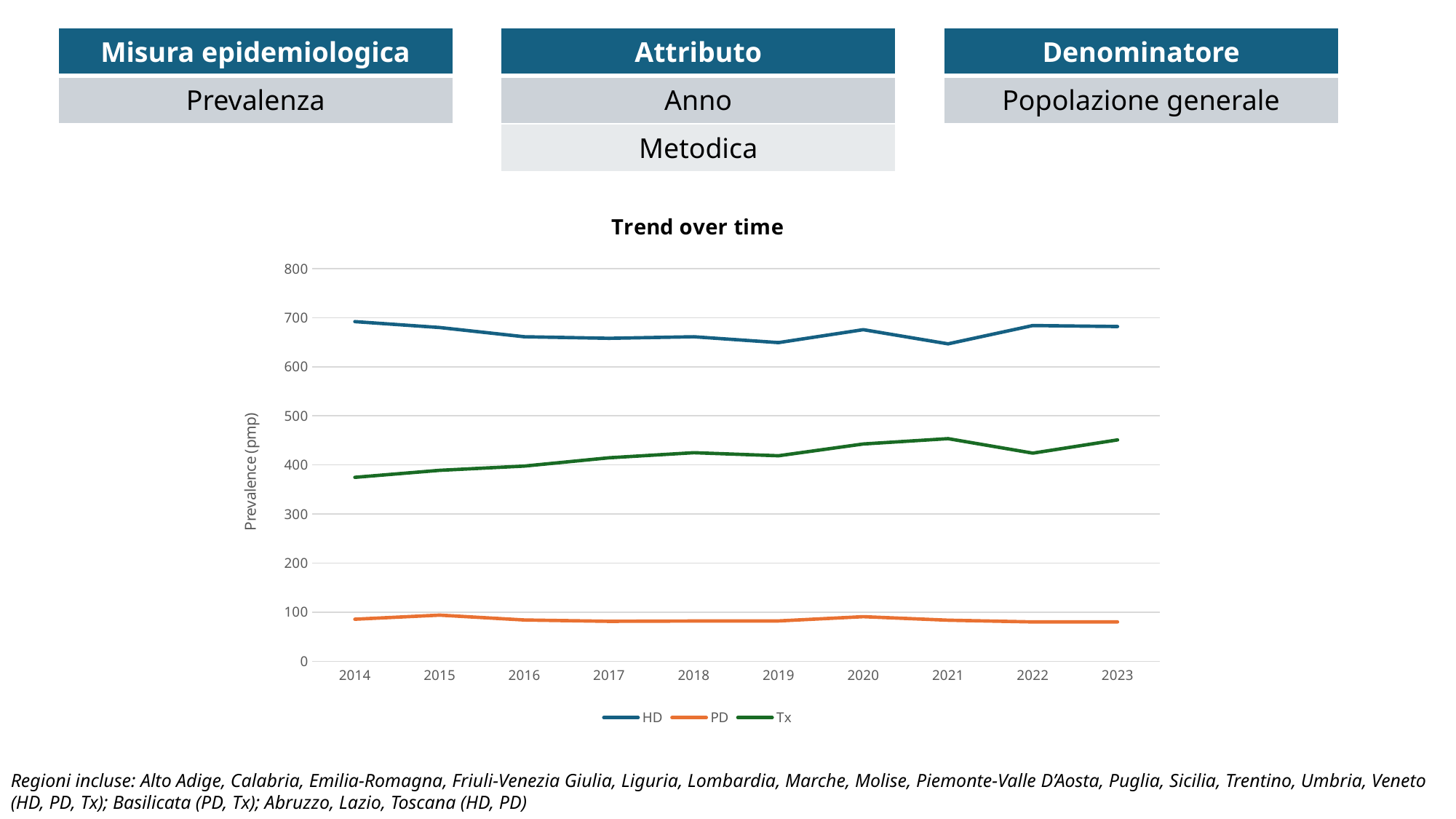
Is the value for HD in 2014 greater or less than 600? greater Does the Tx series rise or fall overall from 2014 to 2023? rise Is the value for Tx in 2021 greater or less than 400? greater How many series does the legend of the "Trend over time" chart list? 3 Which series has the lowest values across all years shown? PD Is the value for PD in 2023 greater or less than 100? less Which series has the highest value in 2020? HD How many years are plotted along the x axis of the "Trend over time" chart? 10 What is the label on the y axis of the chart? Prevalence (pmp) What kind of chart is shown under the title "Trend over time"? line chart In 2023, which series has the larger value, HD or Tx? HD